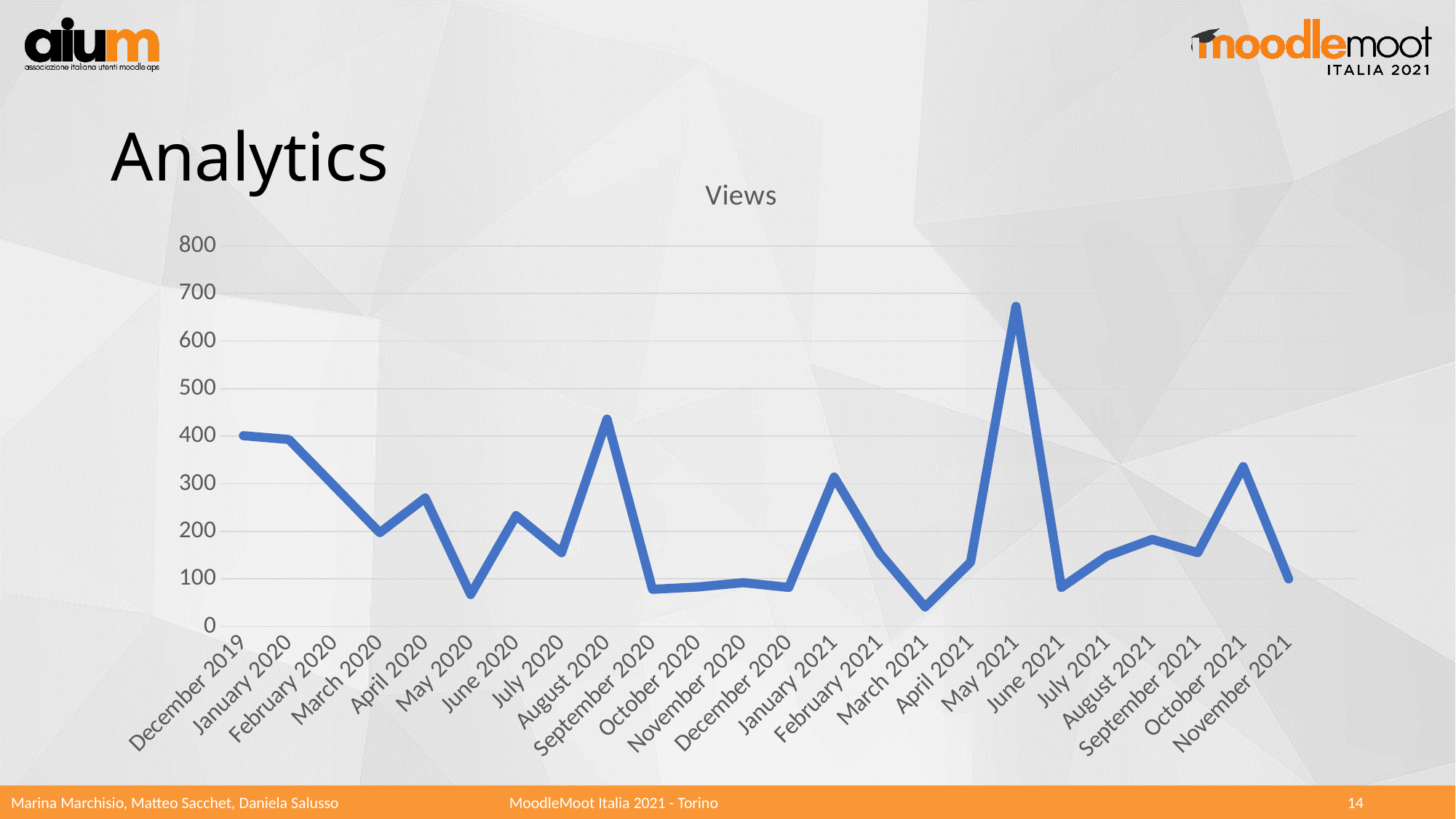
Which is larger, the value for May 2021 or the value for August 2020? May 2021 Is the value for March 2021 greater or less than 100? less What is the title of the chart? Views Do the values rise or fall from December 2019 to May 2020? fall Which month has the highest number of views? May 2021 Is the value for April 2020 greater or less than 200? greater How many months are plotted along the x axis of the chart? 24 What kind of chart is shown on the slide? line chart Is the value for August 2020 greater or less than 400? greater Which is larger, the value for October 2021 or the value for November 2021? October 2021